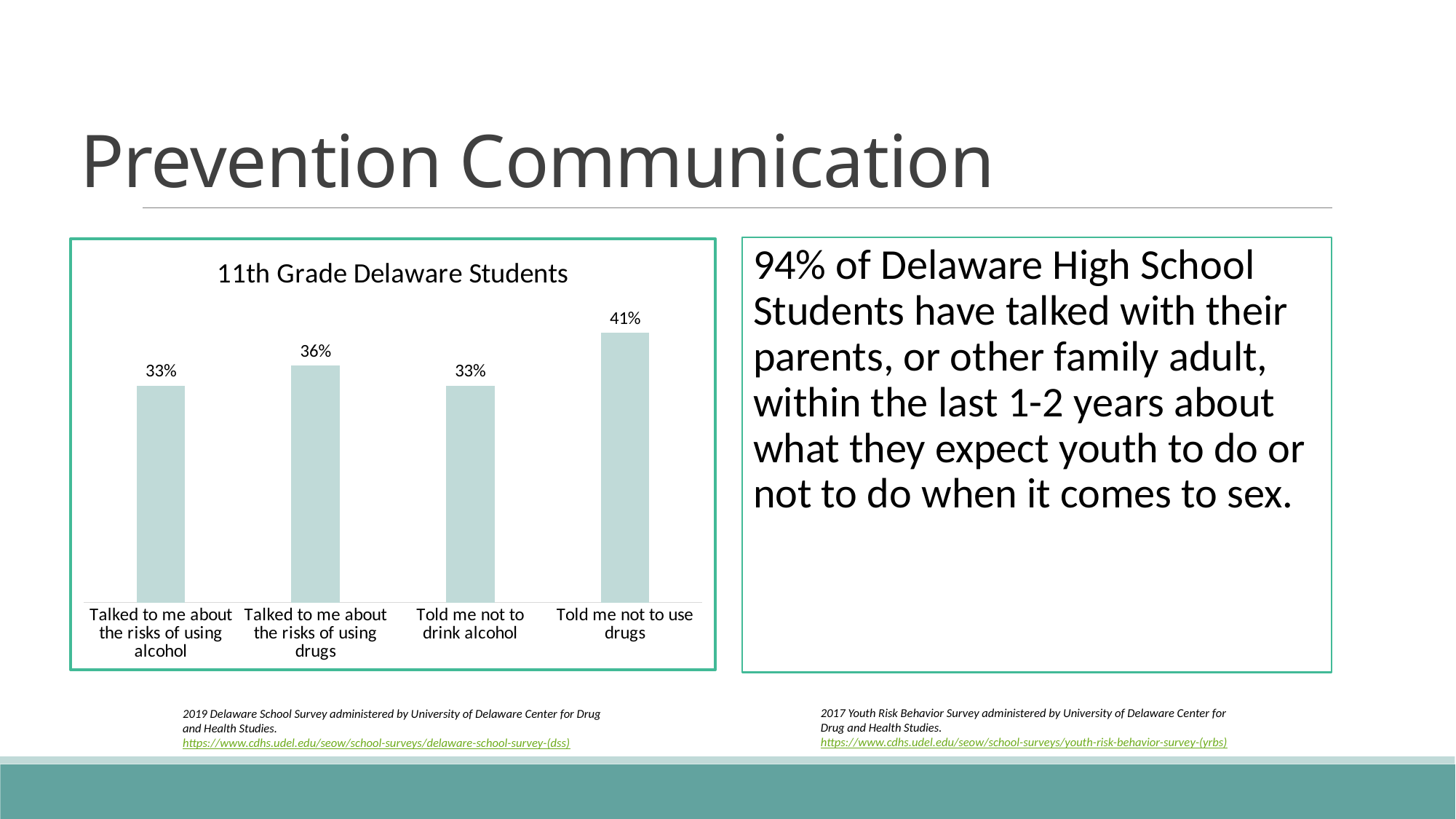
What is the difference between "Told me not to use drugs" and "Talked to me about the risks of using alcohol"? 8% What is the title of the chart? 11th Grade Delaware Students What is the value for "Told me not to drink alcohol"? 33% Which category has the highest value? Told me not to use drugs Which two categories share the same value of 33%? Talked to me about the risks of using alcohol; Told me not to drink alcohol What kind of chart is shown on the slide? Bar chart How many categories are shown in the chart? 4 What is the value for "Talked to me about the risks of using drugs"? 36% Which is larger: "Talked to me about the risks of using drugs" or "Told me not to drink alcohol"? Talked to me about the risks of using drugs What is the value for "Told me not to use drugs"? 41% What is the difference between "Talked to me about the risks of using drugs" and "Told me not to drink alcohol"? 3%